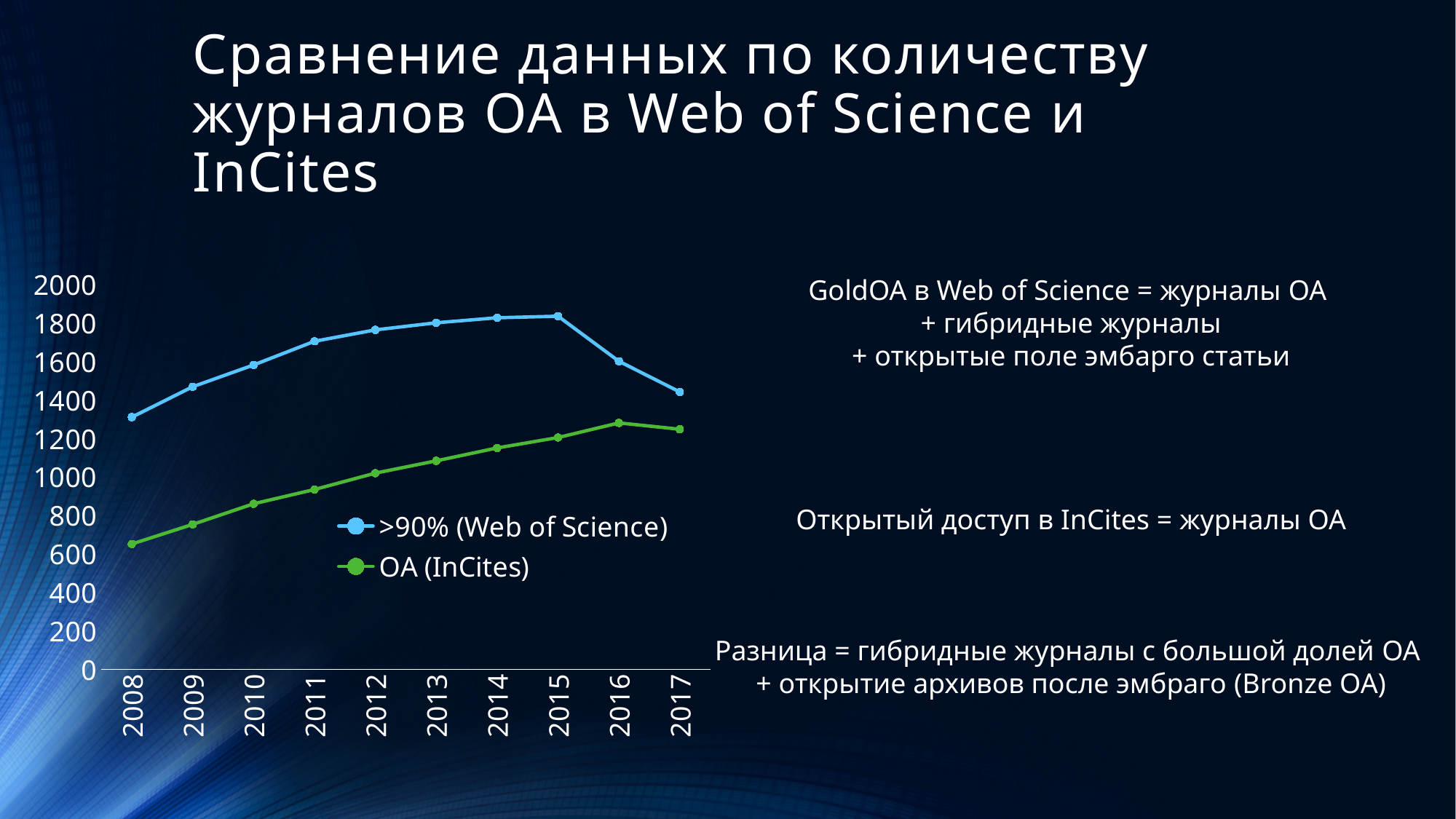
Does the OA (InCites) series rise or fall from 2008 to 2016? rise Is the value for OA (InCites) in 2008 greater or less than 800? less How many series does the chart legend list? 2 In which year is the OA (InCites) series at its lowest? 2008 Which series is drawn in green in the chart? OA (InCites) How many years are shown on the x axis of the chart? 10 Is the value for >90% (Web of Science) in 2008 greater or less than 1200? greater Is the value for OA (InCites) in 2016 greater or less than 1200? greater In which year is the >90% (Web of Science) series at its lowest? 2008 What kind of chart is shown on the slide? line chart